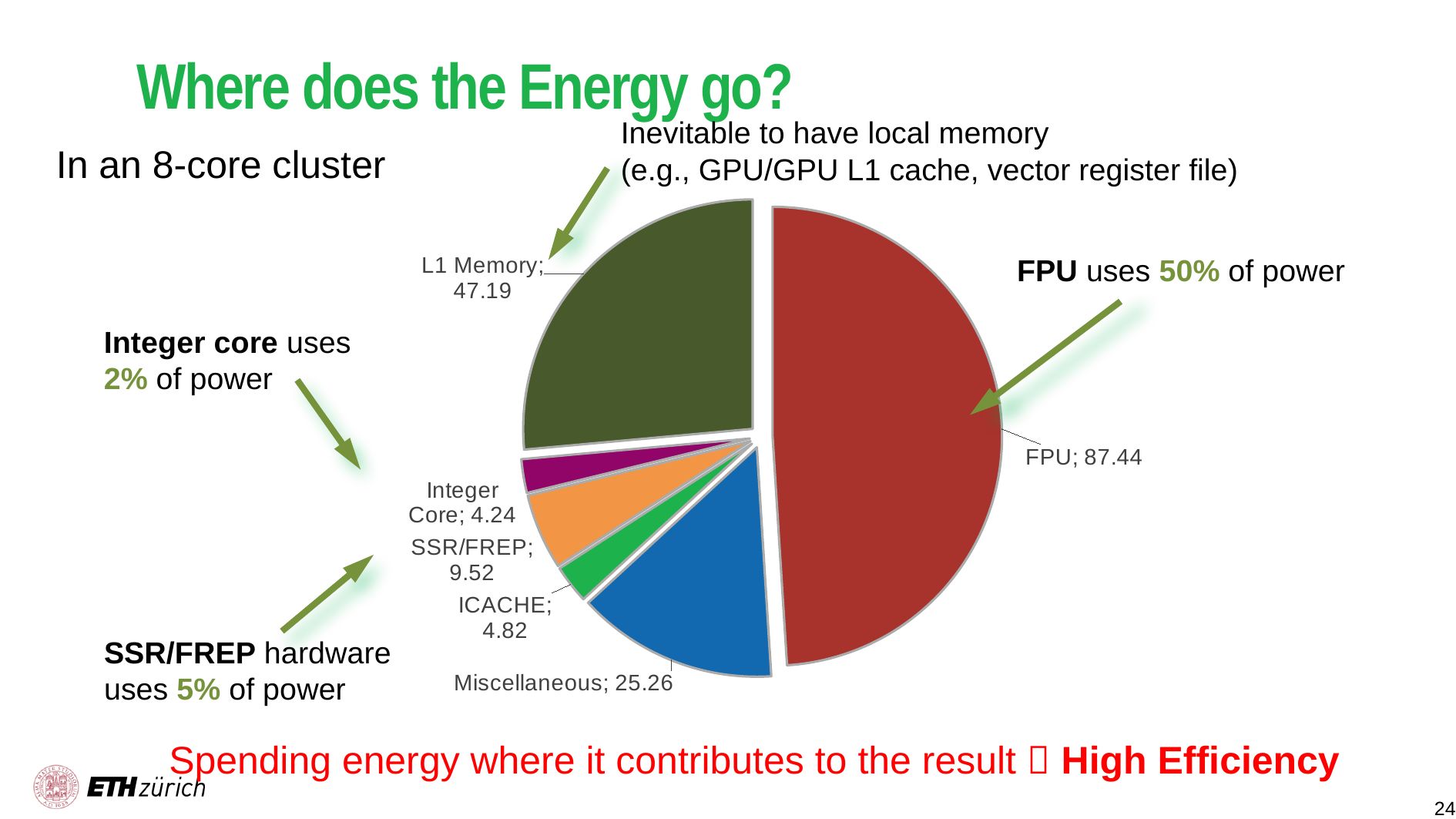
What is the value for SSR/FREP in the pie chart? 9.52 Which slice of the pie chart has the largest value? FPU Which is larger, the value for Miscellaneous or the value for SSR/FREP? Miscellaneous What is the value for ICACHE in the pie chart? 4.82 What is the difference between the FPU value and the L1 Memory value? 40.25 What is the value for FPU in the pie chart? 87.44 What type of chart is shown on the slide? Pie chart Which slice of the pie chart has the smallest value? Integer Core How many slices does the pie chart have? 6 What is the title of the slide containing the pie chart? Where does the Energy go? What is the value for Miscellaneous in the pie chart? 25.26 What is the value for L1 Memory in the pie chart? 47.19